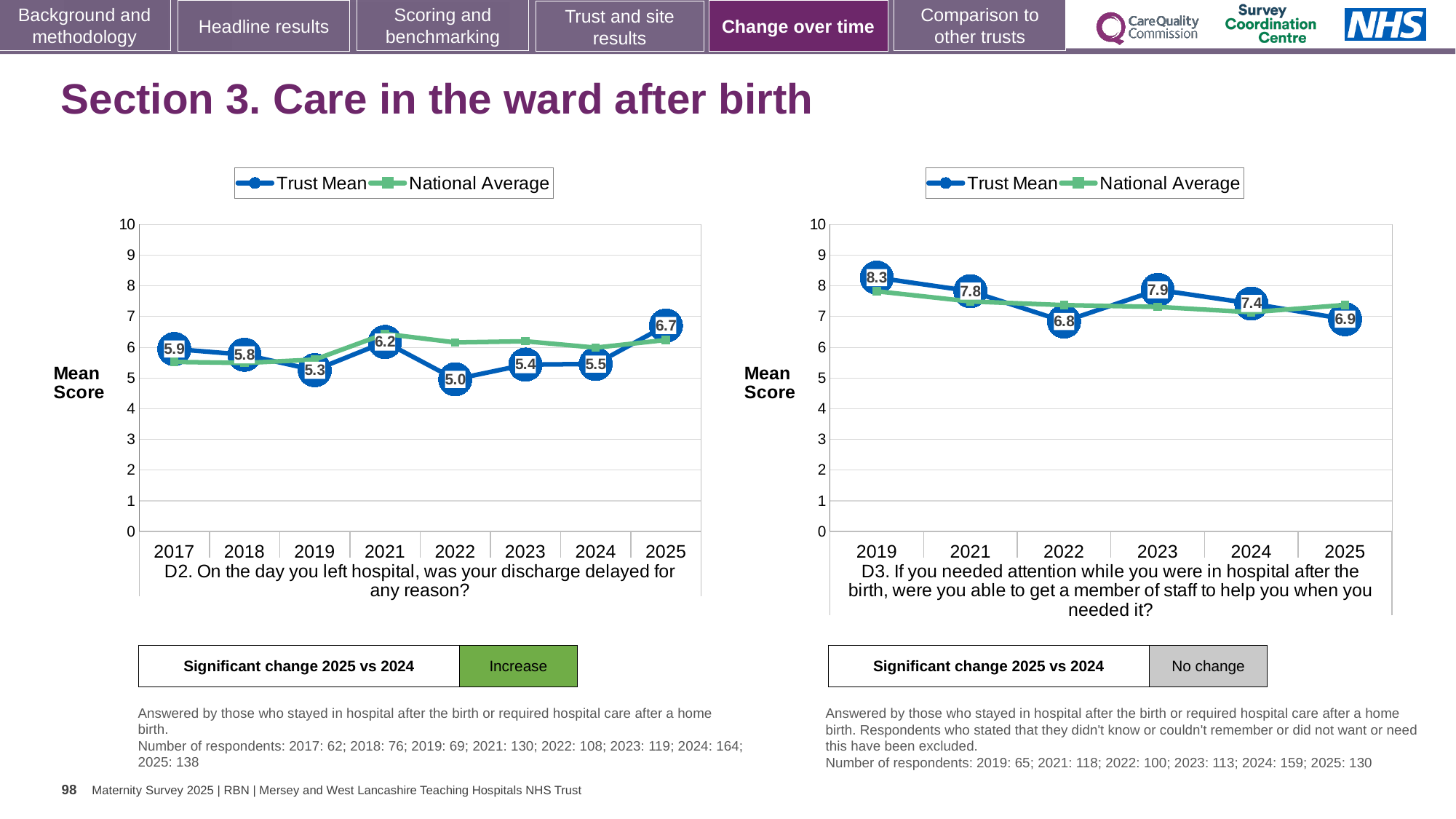
In the D2 chart (left), what is the Trust Mean score for 2022? 5.0 In the D2 chart (left), how many years are plotted on the x axis? 8 In the D3 chart (right), what is the Trust Mean score for 2019? 8.3 In the D2 chart (left), which year has the lowest Trust Mean score? 2022 In the D2 chart (left), what is the difference between the Trust Mean scores for 2025 and 2024? 1.2 In the D2 chart (left), what is the Trust Mean score for 2025? 6.7 In the D3 chart (right), is the National Average value for 2019 greater or less than 7? greater In the D3 chart (right), which year has the lowest Trust Mean score? 2022 How many series does the legend of the D3 chart (right) list? 2 In the D3 chart (right), is the Trust Mean score for 2023 higher or lower than for 2024? higher What kind of chart is the D2 chart (left)? line chart In the D2 chart (left), which year has the highest Trust Mean score? 2025